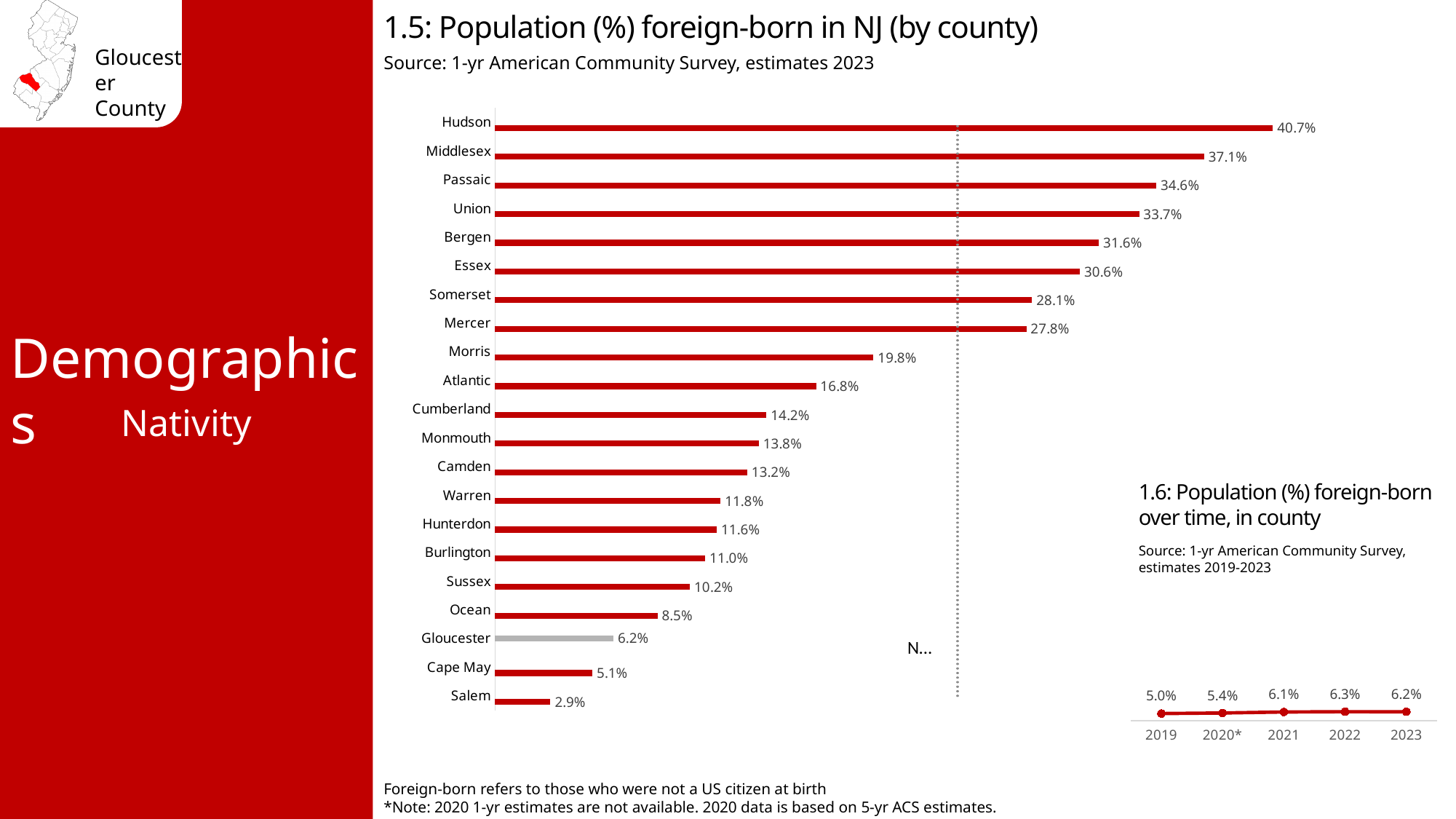
In the chart '1.6: Population (%) foreign-born over time, in county', which year has the highest value? 2022 In the chart '1.5: Population (%) foreign-born in NJ (by county)', which county has the highest value? Hudson In the chart '1.5: Population (%) foreign-born in NJ (by county)', what is the value for Gloucester? 6.2% What kind of chart is '1.5: Population (%) foreign-born in NJ (by county)'? bar chart In the chart '1.5: Population (%) foreign-born in NJ (by county)', which county has the lowest value? Salem In the chart '1.6: Population (%) foreign-born over time, in county', what is the difference between 2019 and 2023? 1.2% In the chart '1.6: Population (%) foreign-born over time, in county', what is the value for 2021? 6.1% In the chart '1.5: Population (%) foreign-born in NJ (by county)', what is the value for Hudson? 40.7% How many counties are shown in the chart '1.5: Population (%) foreign-born in NJ (by county)'? 21 In the chart '1.5: Population (%) foreign-born in NJ (by county)', which is larger, Camden or Monmouth? Monmouth In the chart '1.5: Population (%) foreign-born in NJ (by county)', what is the difference between Middlesex and Passaic? 2.5% In the chart '1.5: Population (%) foreign-born in NJ (by county)', which bar is coloured grey instead of red? Gloucester